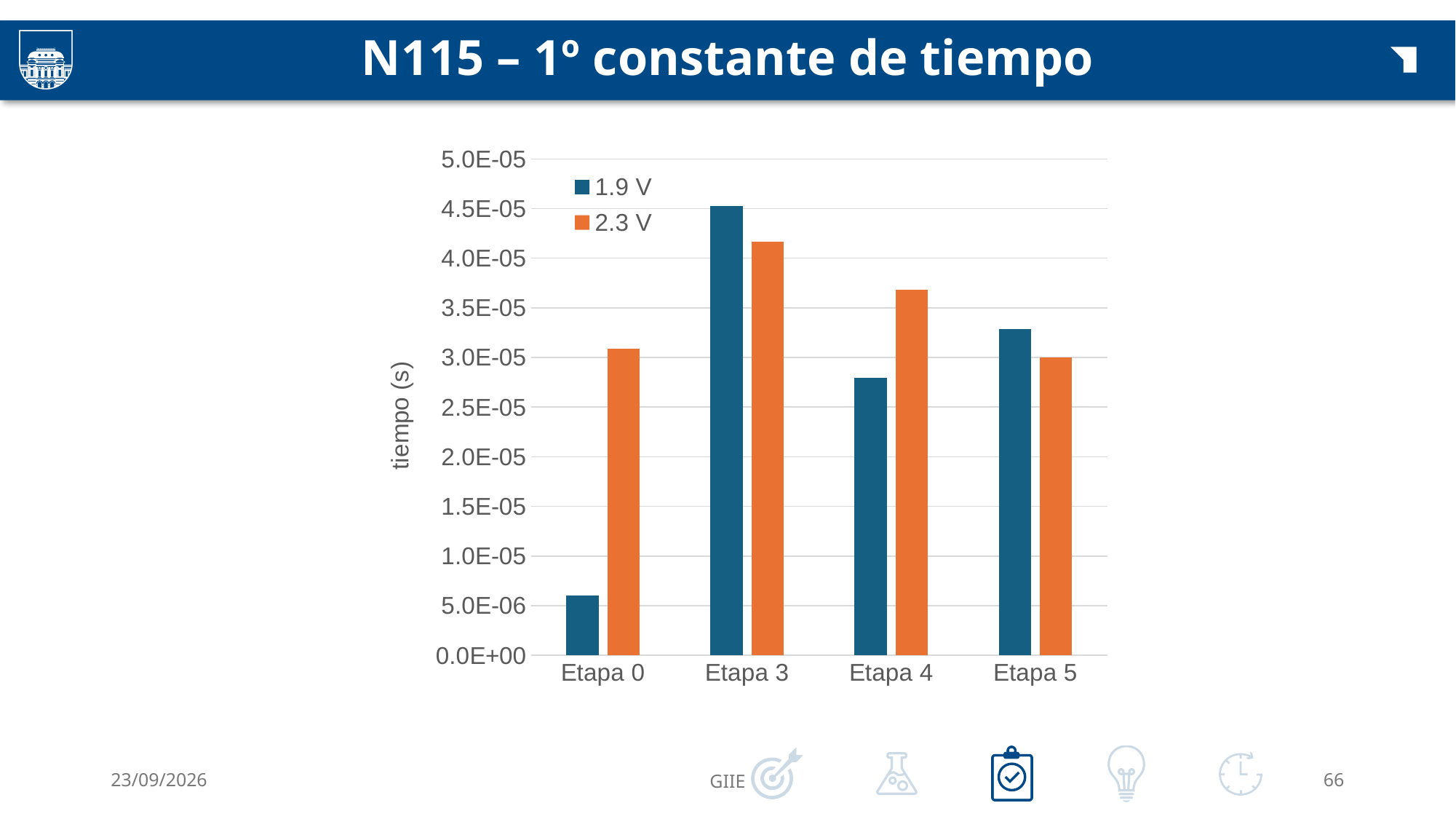
For the 2.3 V series, which etapa has the highest value? Etapa 3 How many series does the legend list? 2 For the 1.9 V series, which etapa has the lowest value? Etapa 0 Which series is shown in orange? 2.3 V How many categories (etapas) are shown on the x axis? 4 What kind of chart is shown on the slide? bar chart At Etapa 3, which series has the larger value, 1.9 V or 2.3 V? 1.9 V Is the 2.3 V value for Etapa 4 greater or less than 3.5E-05? greater For the 1.9 V series, which etapa has the highest value? Etapa 3 Is the 1.9 V value for Etapa 0 greater or less than 1.0E-05? less At Etapa 0, which series has the larger value, 1.9 V or 2.3 V? 2.3 V What is the label of the vertical axis? tiempo (s)